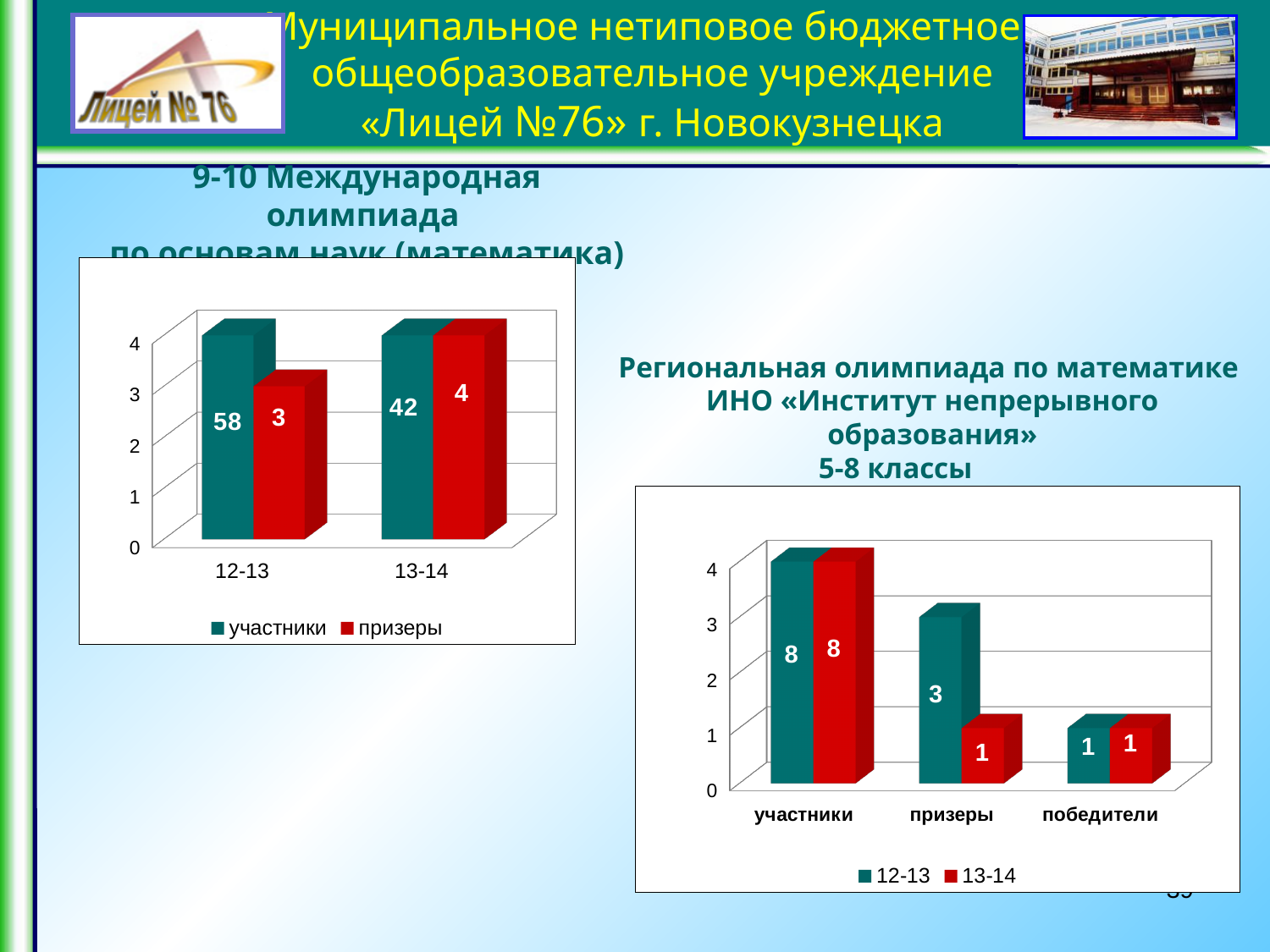
In the left chart (9-10 Международная олимпиада), what is the value for участники in 13-14? 42 In the right chart (Региональная олимпиада по математике), what is the value for 12-13 in участники? 8 In the left chart (9-10 Международная олимпиада), what is the difference between участники and призеры in 12-13? 55 In the right chart (Региональная олимпиада по математике), which is larger for призеры: 12-13 or 13-14? 12-13 In the left chart (9-10 Международная олимпиада), how many series does the legend list? 2 In the right chart (Региональная олимпиада по математике), which category has the highest value for the 12-13 series? участники In the right chart (Региональная олимпиада по математике), what is the difference between 12-13 and 13-14 for призеры? 2 In the right chart (Региональная олимпиада по математике), how many categories are shown on the x axis? 3 In the left chart (9-10 Международная олимпиада), what is the value for участники in 12-13? 58 In the right chart (Региональная олимпиада по математике), what is the value for 13-14 in призеры? 1 What type of chart is the right chart (Региональная олимпиада по математике)? bar chart In the left chart (9-10 Международная олимпиада), what is the value for призеры in 13-14? 4